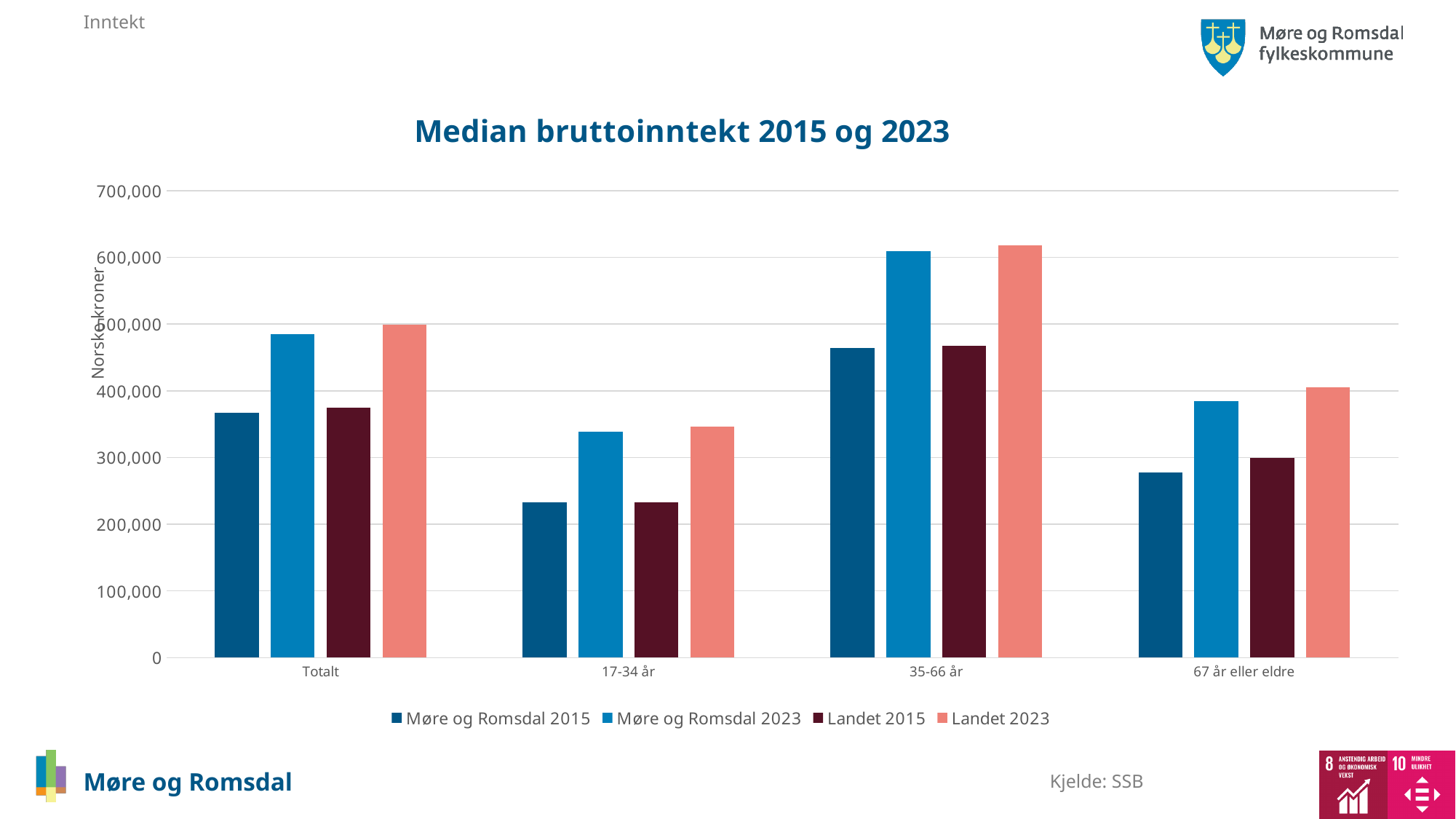
In the 67 år eller eldre category, which is larger: Landet 2015 or Møre og Romsdal 2015? Landet 2015 Is the value for Møre og Romsdal 2023 in the 35-66 år category greater or less than 600,000? greater How many age-group categories are shown on the x axis? 4 What is the title of the chart? Median bruttoinntekt 2015 og 2023 Is the value for Møre og Romsdal 2023 in the Totalt category greater or less than 500,000? less Is the value for Møre og Romsdal 2015 in the 17-34 år category greater or less than 200,000? greater In the 67 år eller eldre category, which is larger: Landet 2023 or Møre og Romsdal 2023? Landet 2023 How many series does the legend list? 4 What kind of chart is shown on the slide? Bar chart Which category has the lowest value for Landet 2023? 17-34 år Which category has the highest value for Møre og Romsdal 2023? 35-66 år